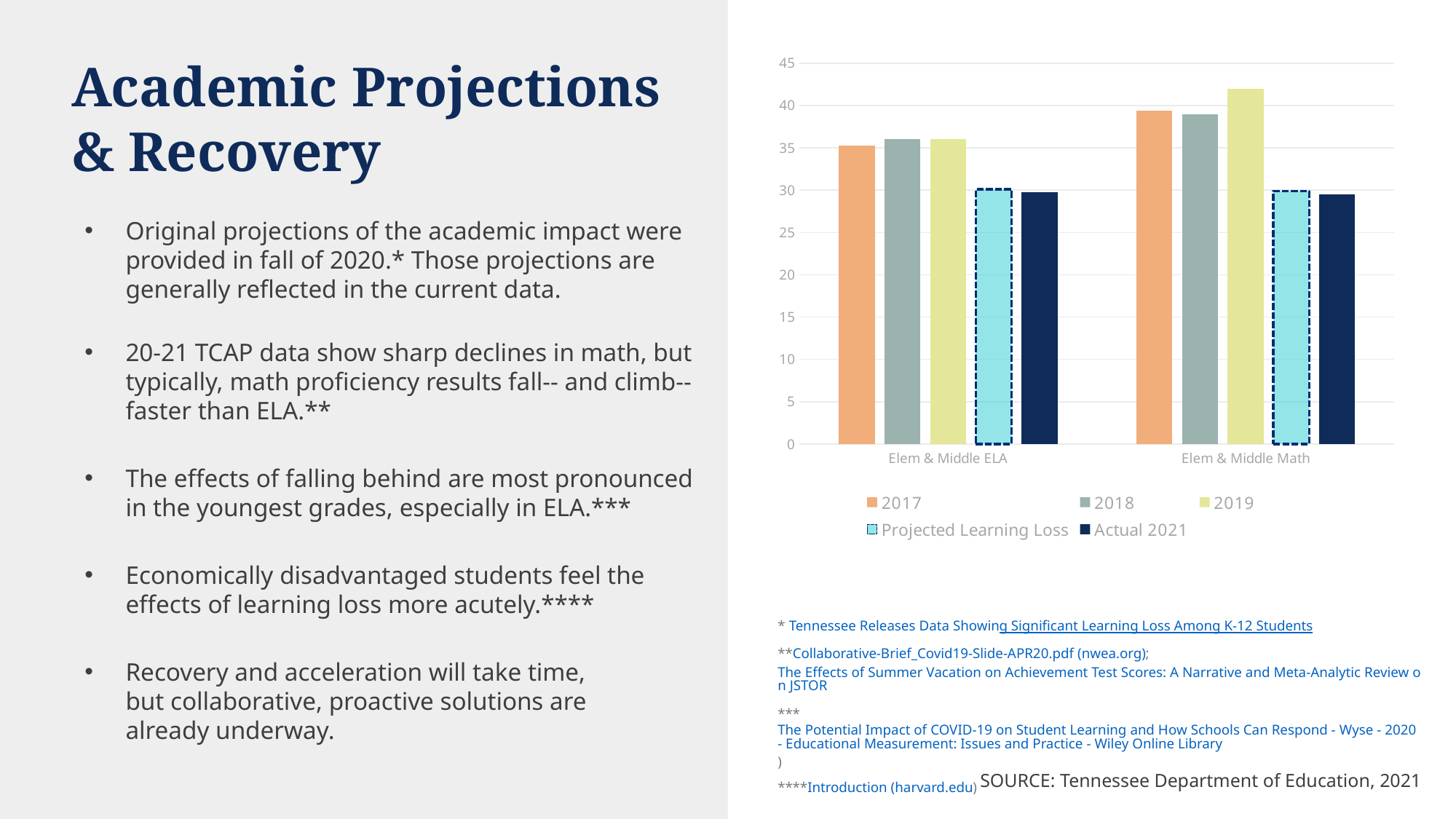
Is the value for 2018 in Elem & Middle Math greater or less than 40? less Which series and category has the highest bar in the chart? 2019, Elem & Middle Math Which series in the legend is drawn with a dashed outline? Projected Learning Loss Is the value for Projected Learning Loss in Elem & Middle Math greater or less than 35? less Is the value for 2017 in Elem & Middle ELA greater or less than 30? greater What kind of chart is shown on the slide? bar chart Which is larger: the 2019 value for Elem & Middle Math or the 2019 value for Elem & Middle ELA? Elem & Middle Math How many series does the chart's legend list? 5 How many categories are shown on the x axis of the chart? 2 Which is larger in Elem & Middle Math: the 2017 value or the Actual 2021 value? 2017